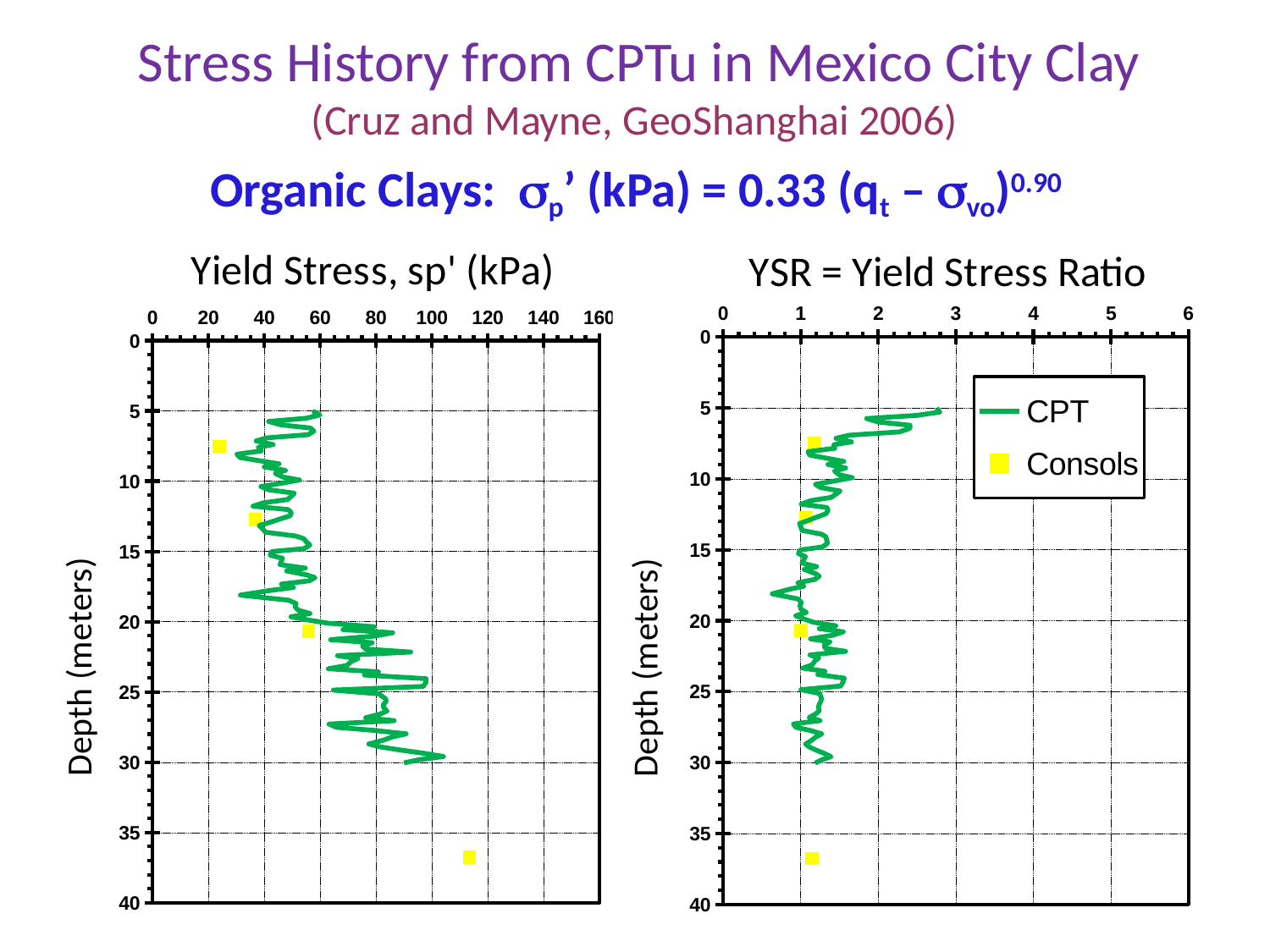
On the right chart "YSR = Yield Stress Ratio", is the YSR of the deepest Consols point (near 37 m depth) greater or less than 2? less What is the label of the vertical axis on both charts? Depth (meters) On the right chart "YSR = Yield Stress Ratio", how many Consols data points are plotted? 4 On the left chart "Yield Stress, sp' (kPa)", is the yield stress of the deepest Consols point (near 37 m depth) greater or less than 100? greater On the right chart "YSR = Yield Stress Ratio", what are the two legend entries? CPT and Consols On the right chart "YSR = Yield Stress Ratio", is the peak YSR of the CPT line near 5 m depth greater or less than 2? greater What kind of chart is the left chart titled "Yield Stress, sp' (kPa)"? line chart On the left chart "Yield Stress, sp' (kPa)", which Consols point has the larger yield stress: the one near 21 m depth or the one near 7.5 m depth? the one near 21 m depth On the right chart "YSR = Yield Stress Ratio", how many series does the legend list? 2 On the left chart "Yield Stress, sp' (kPa)", how many Consols data points are plotted? 4 On the left chart "Yield Stress, sp' (kPa)", does the CPT yield stress generally increase or decrease as depth goes from 5 m to 30 m? increase